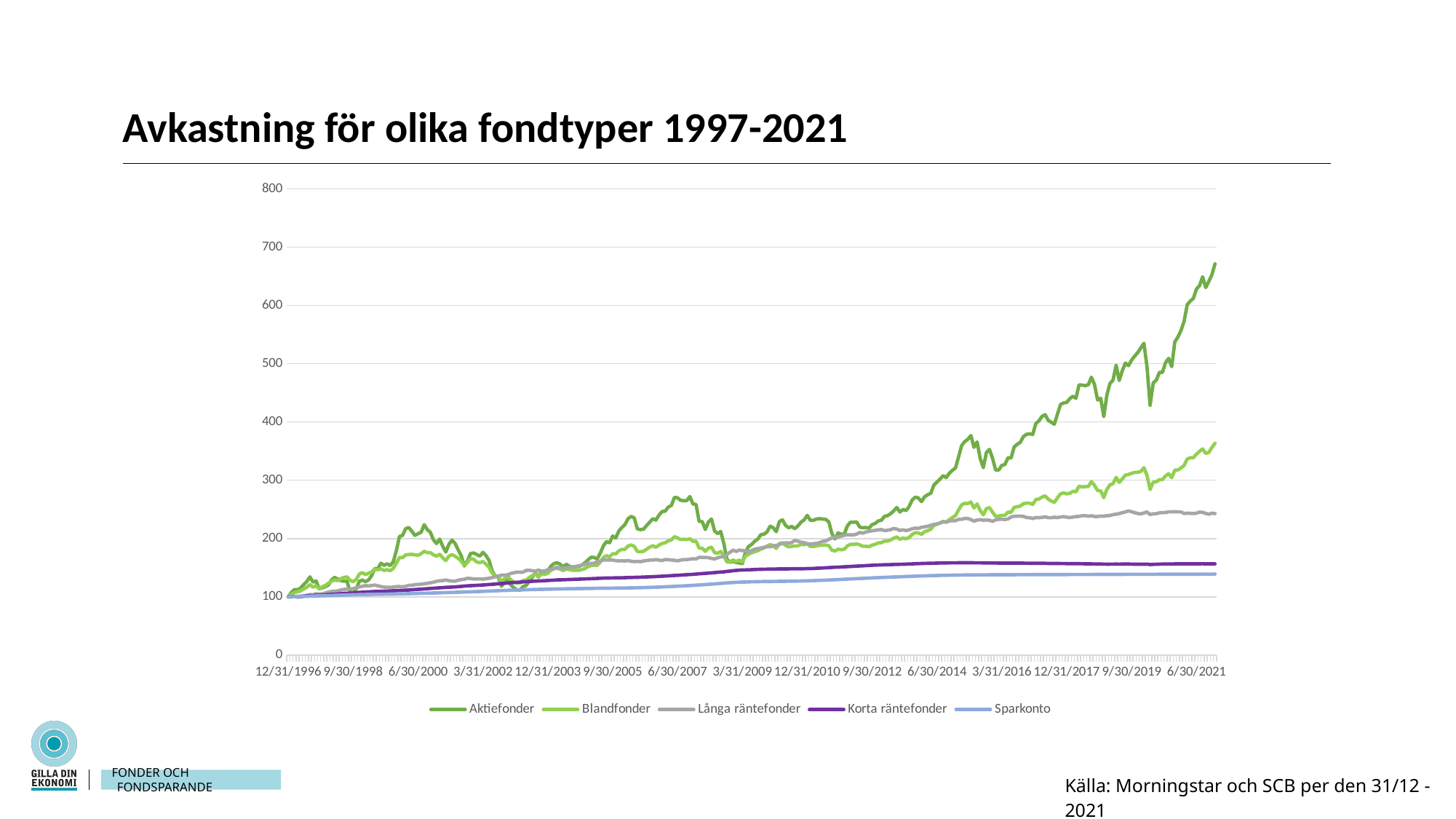
Which series has the lowest value at the end of the period (6/30/2021)? Sparkonto What kind of chart is shown on the slide? line chart Is the value for Långa räntefonder at the end of the period greater or less than 200? greater What is the title of the chart? Avkastning för olika fondtyper 1997-2021 Does the Aktiefonder series rise or fall overall from 1997 to 2021? rise Is the value for Aktiefonder at the end of the period greater or less than 600? greater Which series has the highest value at the end of the period (6/30/2021)? Aktiefonder Is the value for Blandfonder at the end of the period greater or less than 300? greater Which series is drawn in purple? Korta räntefonder How many series does the legend list? 5 At the end of the period, which is larger: Blandfonder or Långa räntefonder? Blandfonder